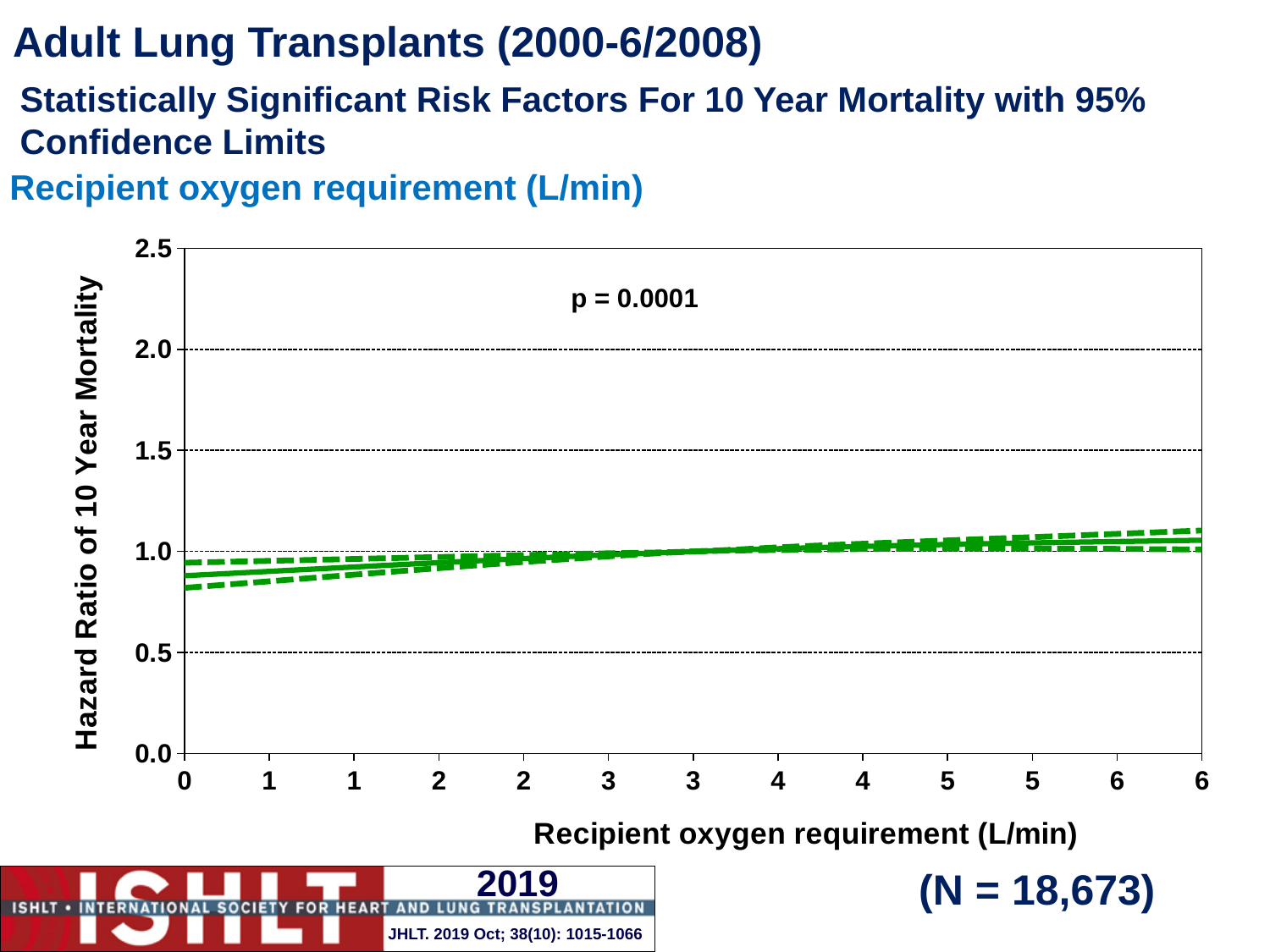
Is the hazard ratio of 10 year mortality at a recipient oxygen requirement of 6 L/min greater or less than 1.5? less Is the hazard ratio of 10 year mortality at a recipient oxygen requirement of 0 L/min greater or less than 0.5? greater Is the hazard ratio of 10 year mortality at a recipient oxygen requirement of 0 L/min greater or less than 1.0? less What is the highest value shown on the y axis of the chart? 2.5 What kind of chart is shown on the slide? line chart How many lines (the hazard ratio curve plus its confidence limits) are plotted on the chart? 3 Does the hazard ratio of 10 year mortality rise or fall as recipient oxygen requirement increases from 0 to 6 L/min? rise What p-value is printed on the chart? p = 0.0001